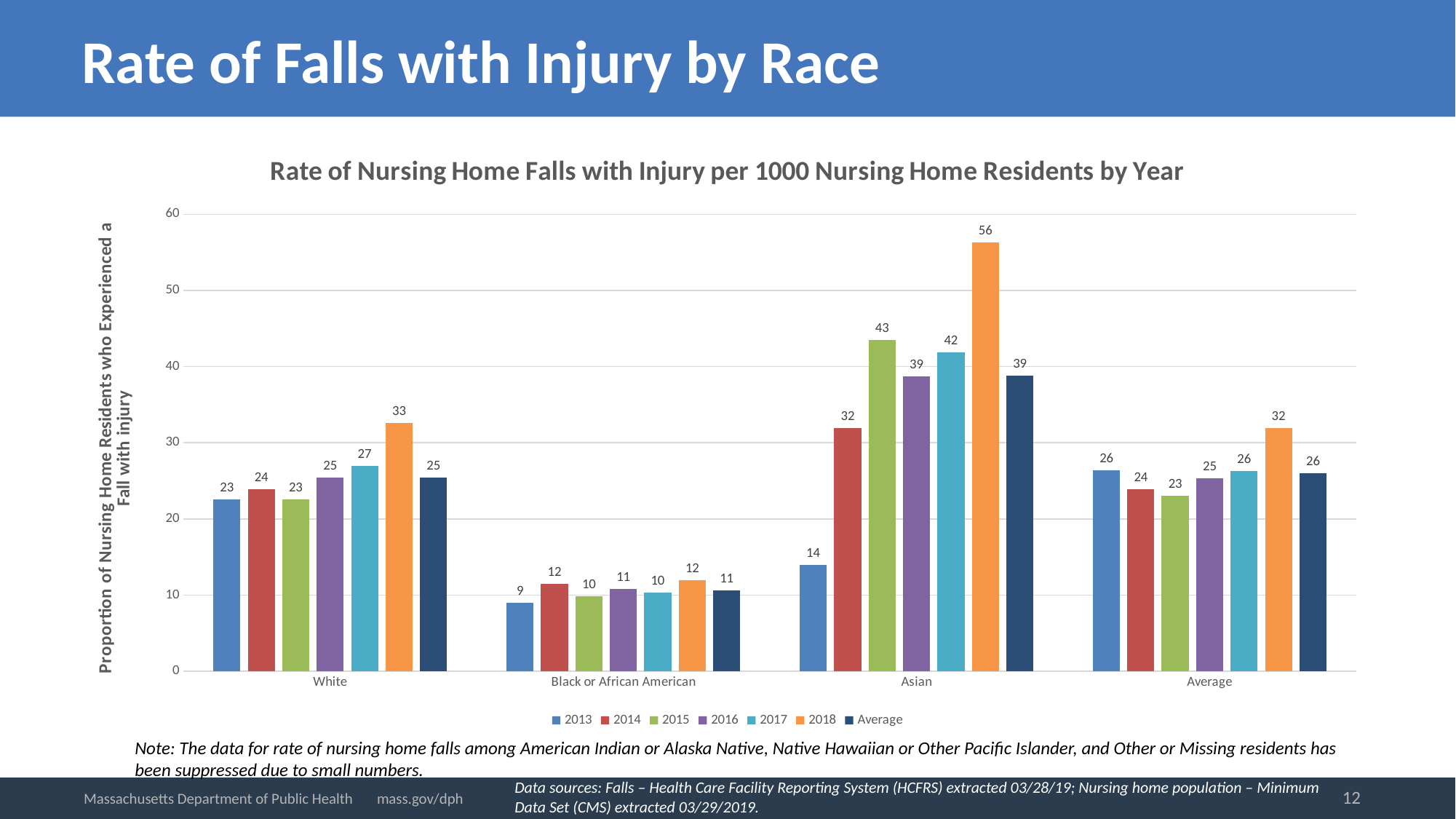
How many race categories are shown on the x axis? 4 What is the difference between the 2018 value for Asian residents and the 2018 value for White residents? 23 Which race category has the highest 2018 value? Asian How many series does the legend list? 7 What is the title of the chart? Rate of Nursing Home Falls with Injury per 1000 Nursing Home Residents by Year What is the rate of falls with injury for Black or African American residents in 2013? 9 What kind of chart is shown on the slide? Bar chart What is the rate of falls with injury for Asian residents in 2018? 56 Is the 2016 value for Asian residents greater or less than 30? greater Which race category has the lowest 2015 value? Black or African American Which is larger: the 2014 value for Asian residents or the 2014 value for White residents? Asian What is the Average series value for White residents? 25